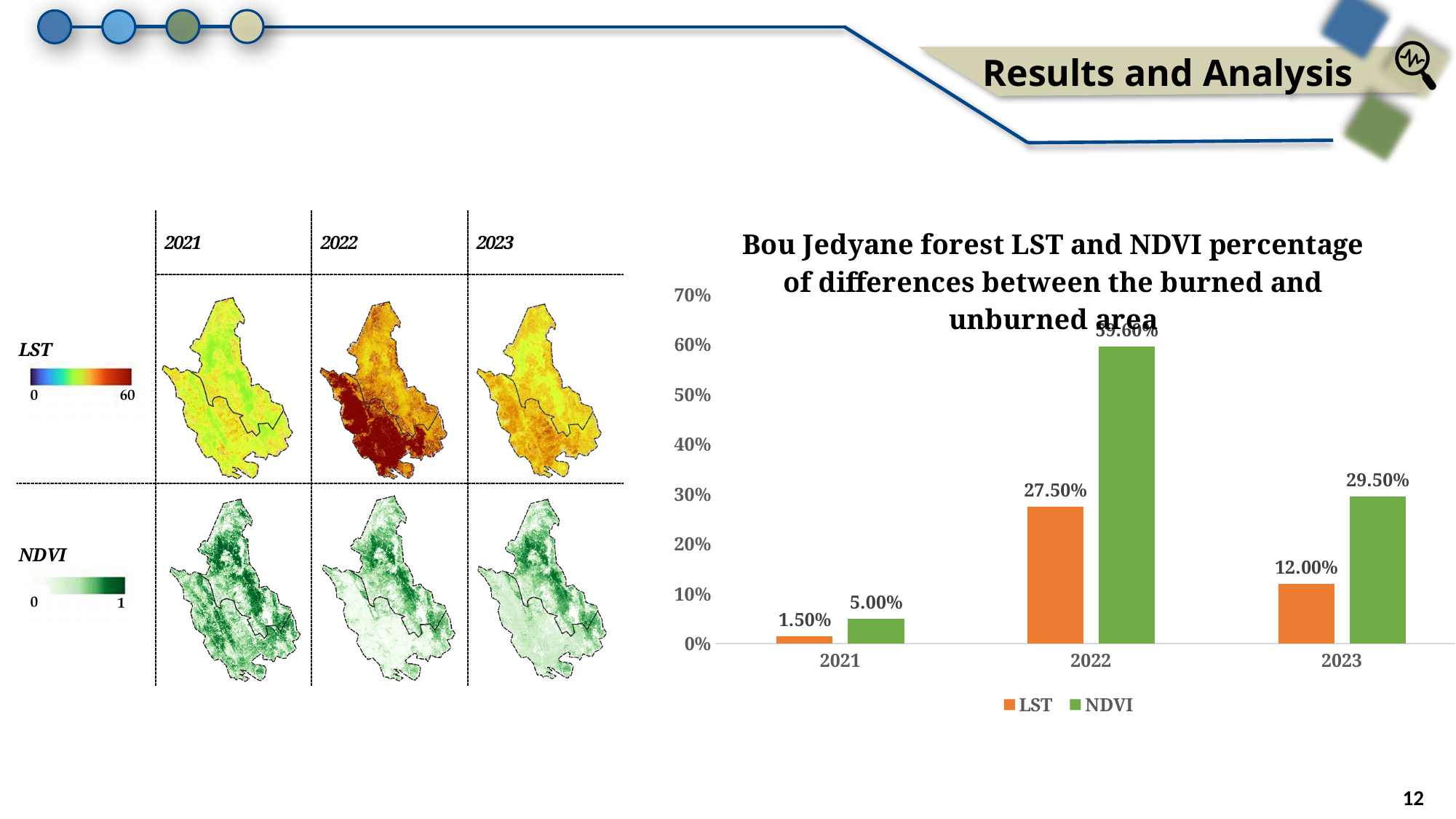
What kind of chart shows the LST and NDVI percentage differences? bar chart What is the NDVI value for 2023 in the bar chart? 29.50% In which year is the LST percentage difference highest? 2022 What is the LST value for 2023 in the bar chart? 12.00% How many series does the legend of the bar chart list? 2 Is the NDVI value for 2022 greater or less than 50%? greater What is the difference between the LST values for 2022 and 2023? 15.50% In which year is the NDVI percentage difference lowest? 2021 In 2023, which is larger, the LST value or the NDVI value? NDVI What is the NDVI value for 2021 in the bar chart? 5.00% What is the LST value for 2022 in the bar chart? 27.50% What is the LST value for 2021 in the bar chart? 1.50%